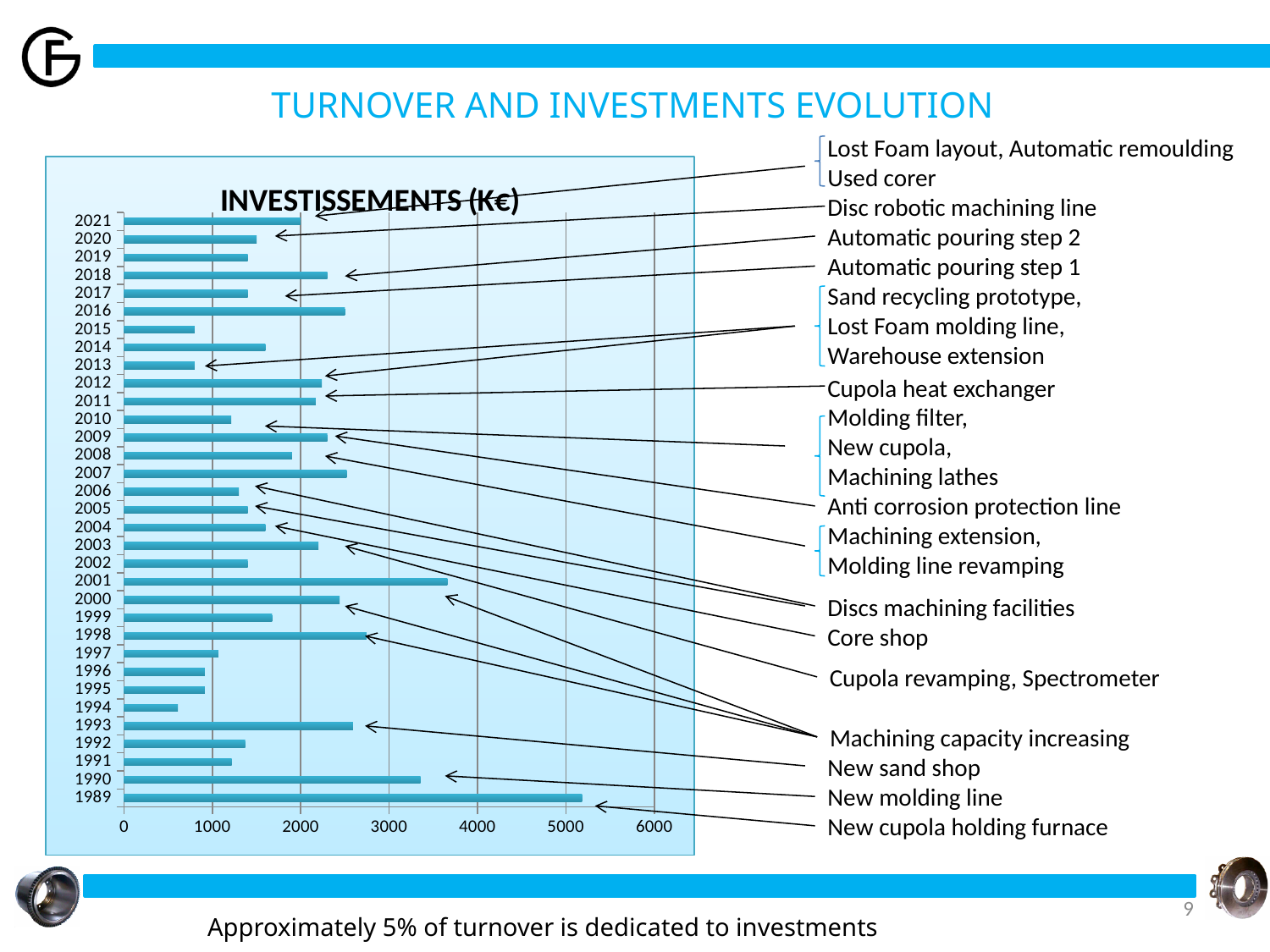
Is the value for 1989 greater or less than 4000? greater Which year has the lowest investment value? 1994 Is the value for 2015 greater or less than 1000? less What is the title of the chart? INVESTISSEMENTS (K€) Is the value for 2001 greater or less than 3000? greater How many years are plotted on the chart? 33 Which year has the highest investment value? 1989 Which is larger, the value for 1989 or the value for 1990? 1989 What kind of chart is shown on the slide? bar chart Which is larger, the value for 2001 or the value for 2000? 2001